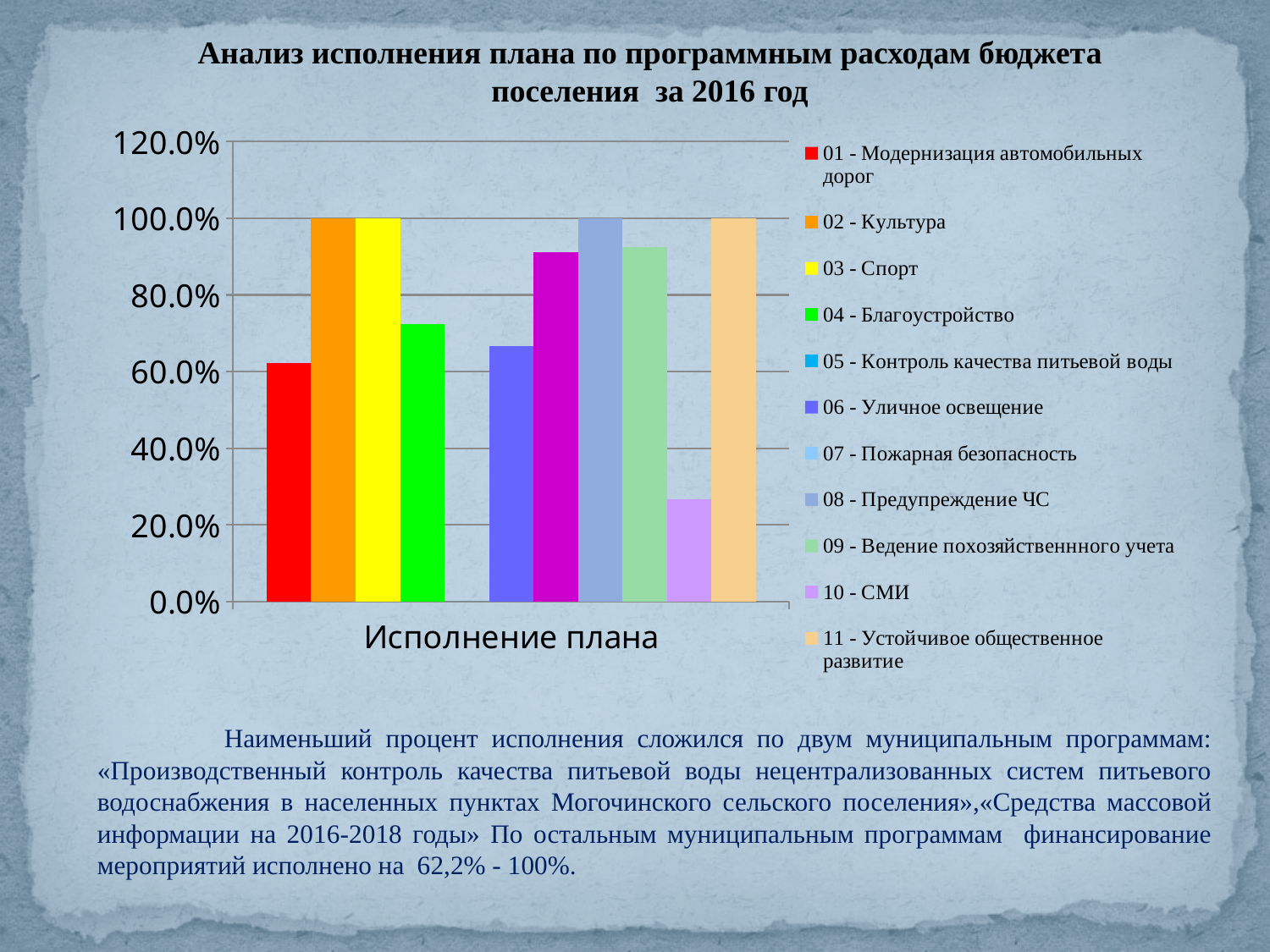
Which is larger, the value for 01 - Модернизация автомобильных дорог or the value for 10 - СМИ? 01 - Модернизация автомобильных дорог What is the value for 11 - Устойчивое общественное развитие? 100.0% Is the value for 01 - Модернизация автомобильных дорог greater or less than 80.0%? less What is the value for 02 - Культура? 100.0% Is the value for 04 - Благоустройство greater or less than 80.0%? less Is the value for 09 - Ведение похозяйственнного учета greater or less than 80.0%? greater What kind of chart is shown on the slide? bar chart What is the label of the single category on the x axis? Исполнение плана How many series does the legend list? 11 What is the value for 03 - Спорт? 100.0% Which is larger, the value for 04 - Благоустройство or the value for 06 - Уличное освещение? 04 - Благоустройство